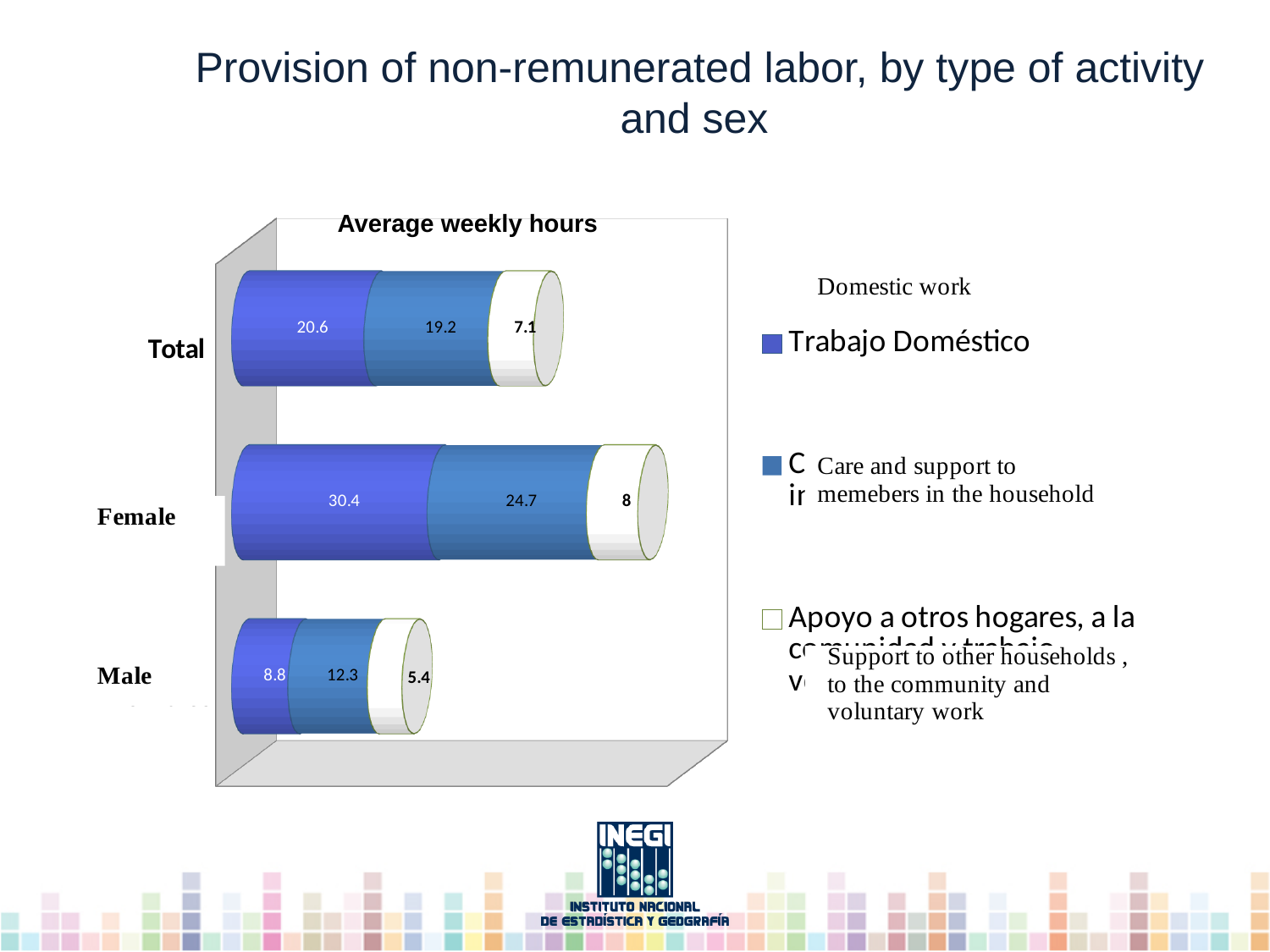
What kind of chart is shown on the slide? Stacked bar chart Which category has the lowest value for support to other households, to the community and voluntary work? Male What is the difference between the domestic work values for females and males? 21.6 How many categories are shown on the chart? 3 Which category has the highest domestic work value? Female How many series does the legend list? 3 Which is larger for males: domestic work or care and support to members in the household? Care and support to members in the household What is the average weekly hours of domestic work for females? 30.4 What is the total of the stacked bar for Female? 63.1 What is the value for care and support to members in the household for males? 12.3 What is the domestic work value for males? 8.8 What is the value for support to other households, to the community and voluntary work for the Total category? 7.1